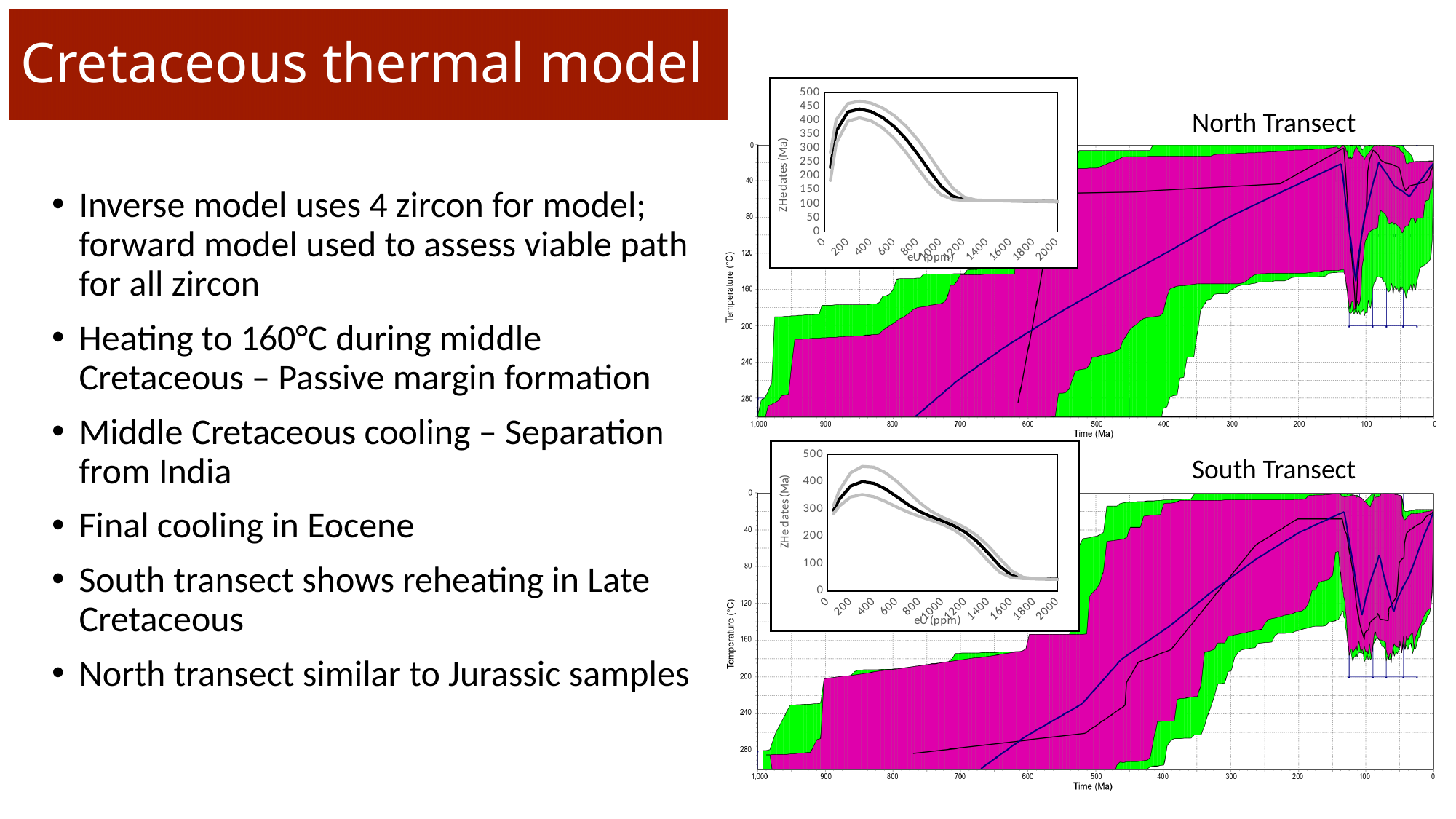
In the inset chart of the North Transect panel, do the ZHe dates rise or fall as eU increases from 400 to 1200 ppm? fall In the inset chart within the North Transect panel, what is the label of the vertical axis? ZHe dates (Ma) What is the maximum value shown on the Time (Ma) axis of the South Transect chart? 1,000 What is the title of the lower main chart on the right side of the slide? South Transect In the inset chart of the North Transect panel, is the black-line ZHe date at eU = 2000 ppm greater or less than 200 Ma? less What kind of chart is the inset chart in the North Transect panel? line chart In the inset chart of the South Transect panel, is the black-line ZHe date at eU = 2000 ppm greater or less than 100 Ma? less In the inset chart of the North Transect panel, is the black-line ZHe date at eU = 400 ppm greater or less than 300 Ma? greater In the inset chart of the South Transect panel, do the ZHe dates rise or fall as eU increases from 400 to 1600 ppm? fall